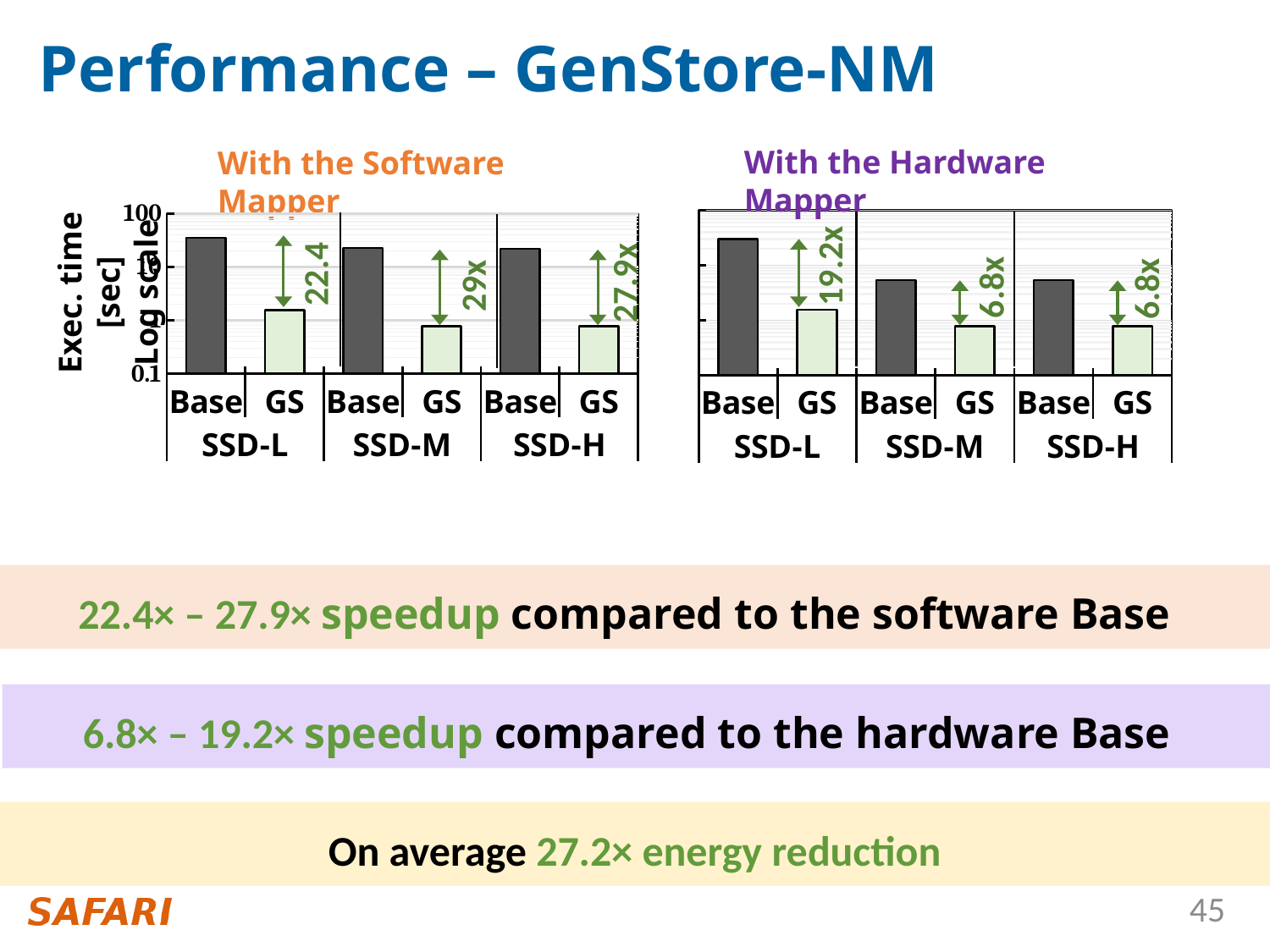
In the "With the Software Mapper" chart, what speedup is annotated for SSD-H? 27.9x In the "With the Software Mapper" chart, what speedup is annotated for SSD-M? 29x What kind of chart is shown under "With the Software Mapper"? bar chart What is the y-axis label of the charts? Exec. time [sec] Log scale In the "With the Hardware Mapper" chart, which SSD configuration has the highest annotated speedup? SSD-L In the "With the Software Mapper" chart, which SSD configuration has the lowest annotated speedup? SSD-L In the "With the Software Mapper" chart, what speedup is annotated for SSD-L? 22.4 In the "With the Hardware Mapper" chart, what speedup is annotated for SSD-M? 6.8x In the "With the Hardware Mapper" chart, what speedup is annotated for SSD-L? 19.2x In the "With the Software Mapper" chart, is the Base execution time for SSD-L greater or less than 10? greater How many SSD configurations are shown in the "With the Hardware Mapper" chart? 3 In the "With the Hardware Mapper" chart, is the Base bar for SSD-L taller or shorter than the GS bar for SSD-L? taller